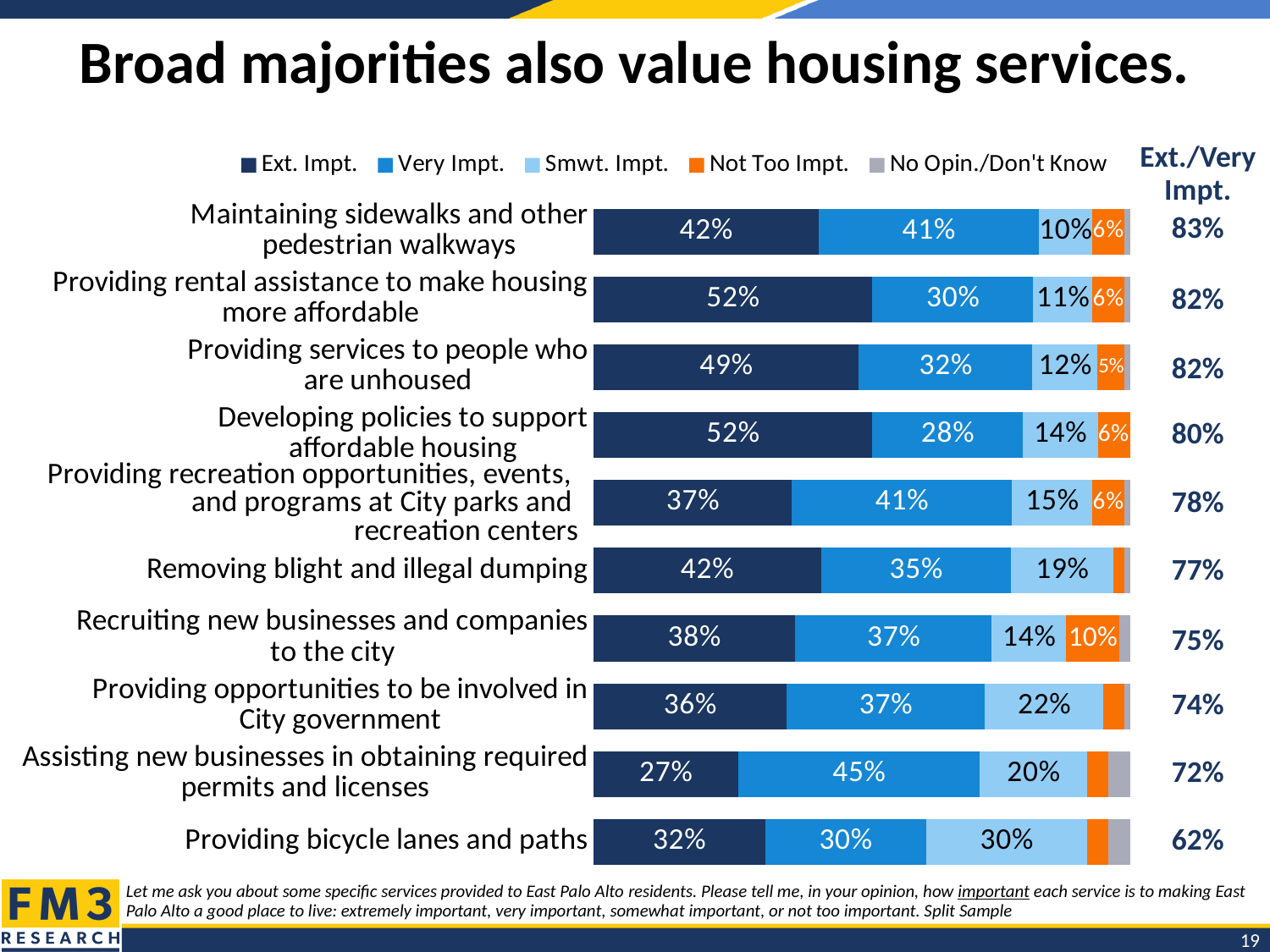
How many series does the legend list? 5 What is the Ext./Very Impt. total shown for "Providing bicycle lanes and paths"? 62% How many services (categories) are plotted in the chart? 10 What is the Ext. Impt. value for "Providing rental assistance to make housing more affordable"? 52% What is the Smwt. Impt. value for "Providing opportunities to be involved in City government"? 22% What is the Very Impt. value for "Assisting new businesses in obtaining required permits and licenses"? 45% Which has a larger Not Too Impt. value: "Recruiting new businesses and companies to the city" or "Maintaining sidewalks and other pedestrian walkways"? Recruiting new businesses and companies to the city What is the title of the slide? Broad majorities also value housing services. Which service has the lowest Ext./Very Impt. combined value? Providing bicycle lanes and paths Which service has the highest Ext./Very Impt. combined value? Maintaining sidewalks and other pedestrian walkways What is the difference between the Ext. Impt. values for "Providing services to people who are unhoused" and "Providing bicycle lanes and paths"? 17% What kind of chart is shown on the slide? Stacked bar chart